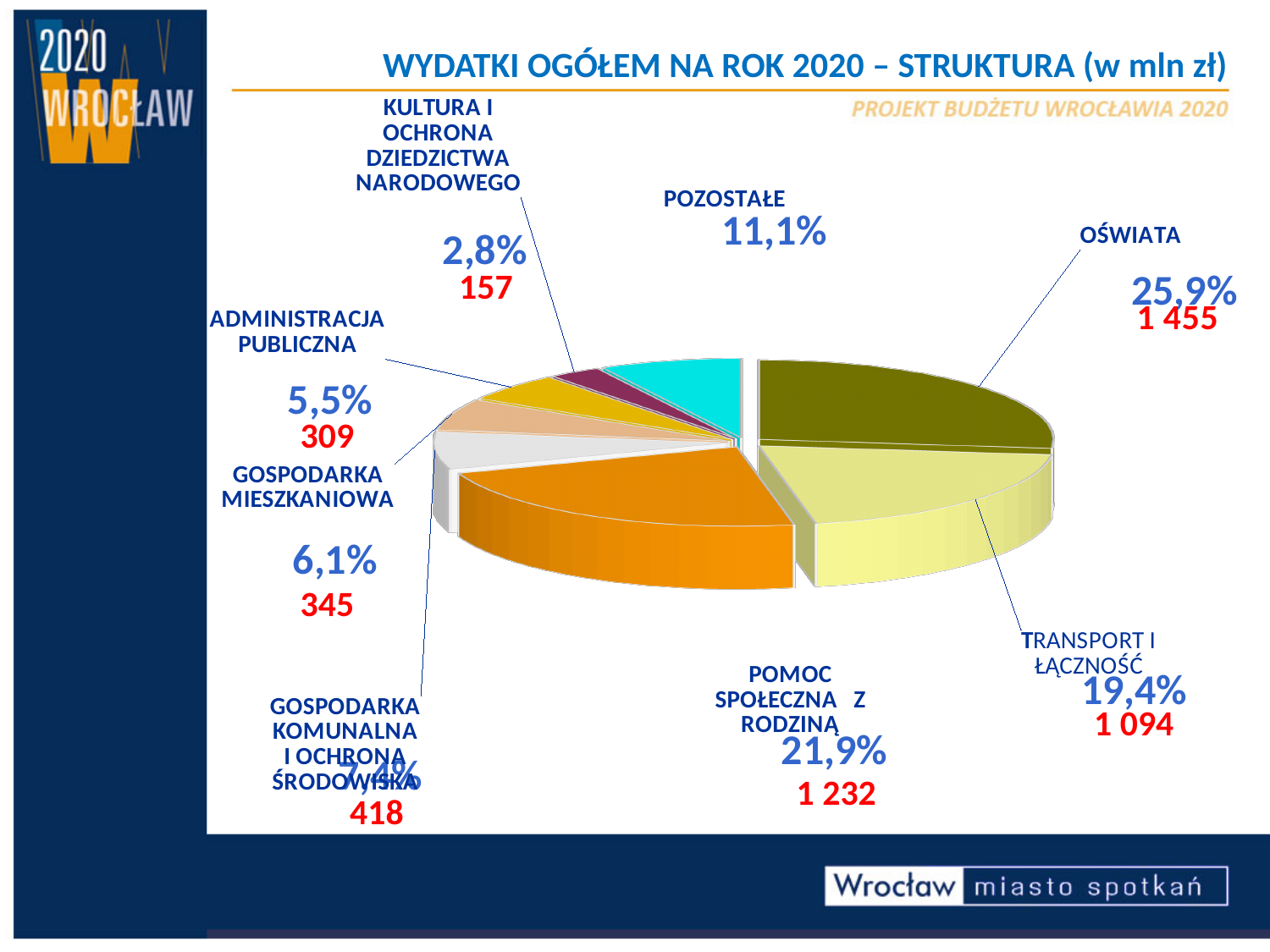
What kind of chart is shown on the slide? pie chart What is the value in mln zł for OŚWIATA? 1 455 What is the title of the chart? WYDATKI OGÓŁEM NA ROK 2020 – STRUKTURA (w mln zł) What is the value in mln zł for POMOC SPOŁECZNA Z RODZINĄ? 1 232 What is the difference in mln zł between OŚWIATA and TRANSPORT I ŁĄCZNOŚĆ? 361 What percentage share does TRANSPORT I ŁĄCZNOŚĆ have? 19,4% Which is larger, the value for GOSPODARKA MIESZKANIOWA or ADMINISTRACJA PUBLICZNA? GOSPODARKA MIESZKANIOWA Which category has the largest share of the pie? OŚWIATA How many categories are shown in the pie chart? 8 What percentage share does KULTURA I OCHRONA DZIEDZICTWA NARODOWEGO have? 2,8% What is the value in mln zł for GOSPODARKA KOMUNALNA I OCHRONA ŚRODOWISKA? 418 Which category has the smallest share of the pie? KULTURA I OCHRONA DZIEDZICTWA NARODOWEGO